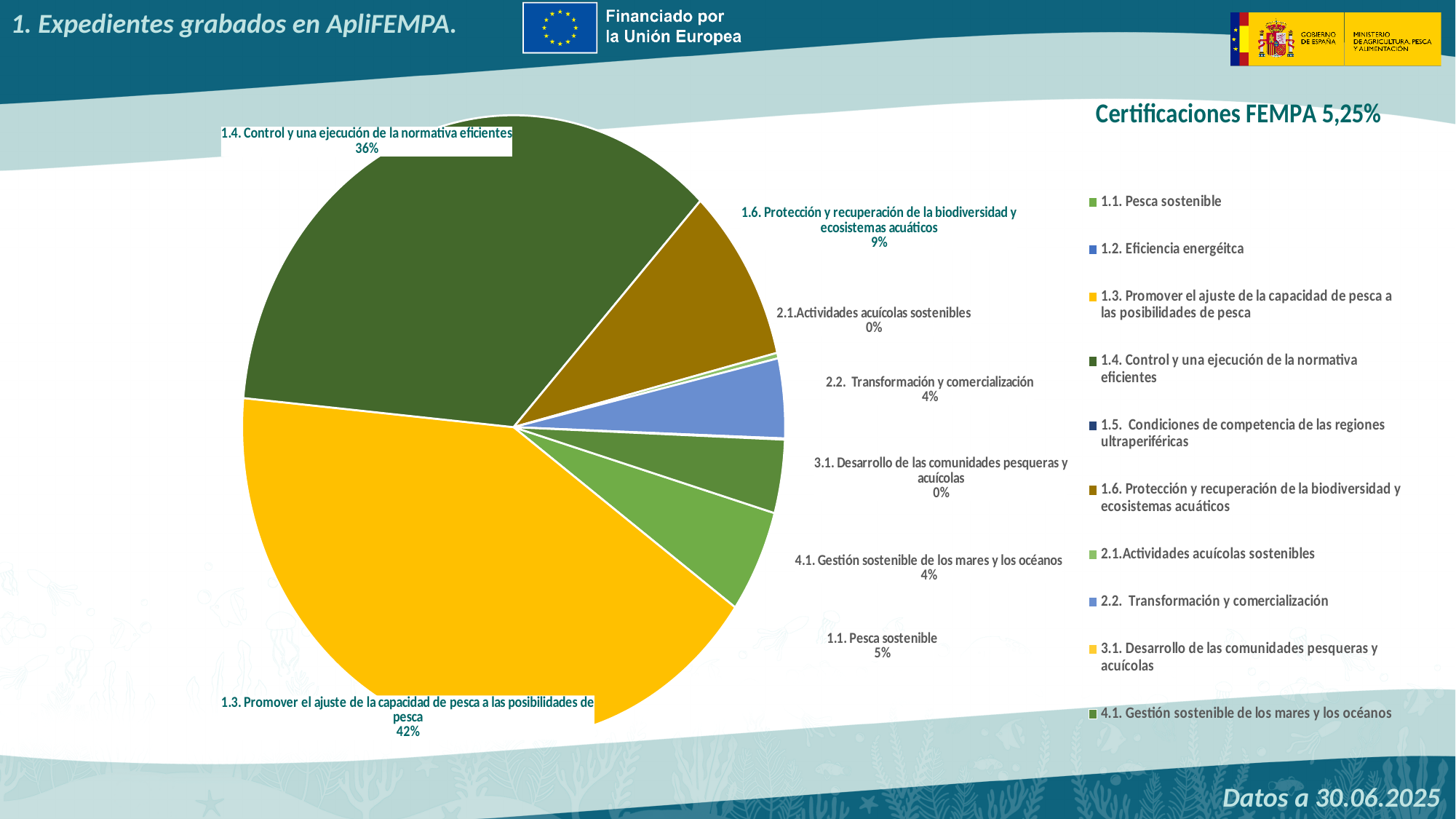
What share of the pie does "1.6. Protección y recuperación de la biodiversidad y ecosistemas acuáticos" represent? 9% Which category has the largest slice of the pie? 1.3. Promover el ajuste de la capacidad de pesca a las posibilidades de pesca What type of chart is shown on the slide? Pie chart What percentage is labelled for "3.1. Desarrollo de las comunidades pesqueras y acuícolas"? 0% What percentage is labelled for "2.2. Transformación y comercialización"? 4% What percentage is shown for "1.4. Control y una ejecución de la normativa eficientes"? 36% How many entries does the legend of the pie chart list? 10 What is the difference in percentage points between "1.3. Promover el ajuste de la capacidad de pesca a las posibilidades de pesca" and "1.4. Control y una ejecución de la normativa eficientes"? 6 percentage points What percentage is shown for "1.3. Promover el ajuste de la capacidad de pesca a las posibilidades de pesca"? 42% What is the title shown above the legend of the chart? Certificaciones FEMPA 5,25% Which is larger: the slice for "1.6. Protección y recuperación de la biodiversidad y ecosistemas acuáticos" or the slice for "1.1. Pesca sostenible"? 1.6. Protección y recuperación de la biodiversidad y ecosistemas acuáticos What percentage is labelled for "1.1. Pesca sostenible"? 5%